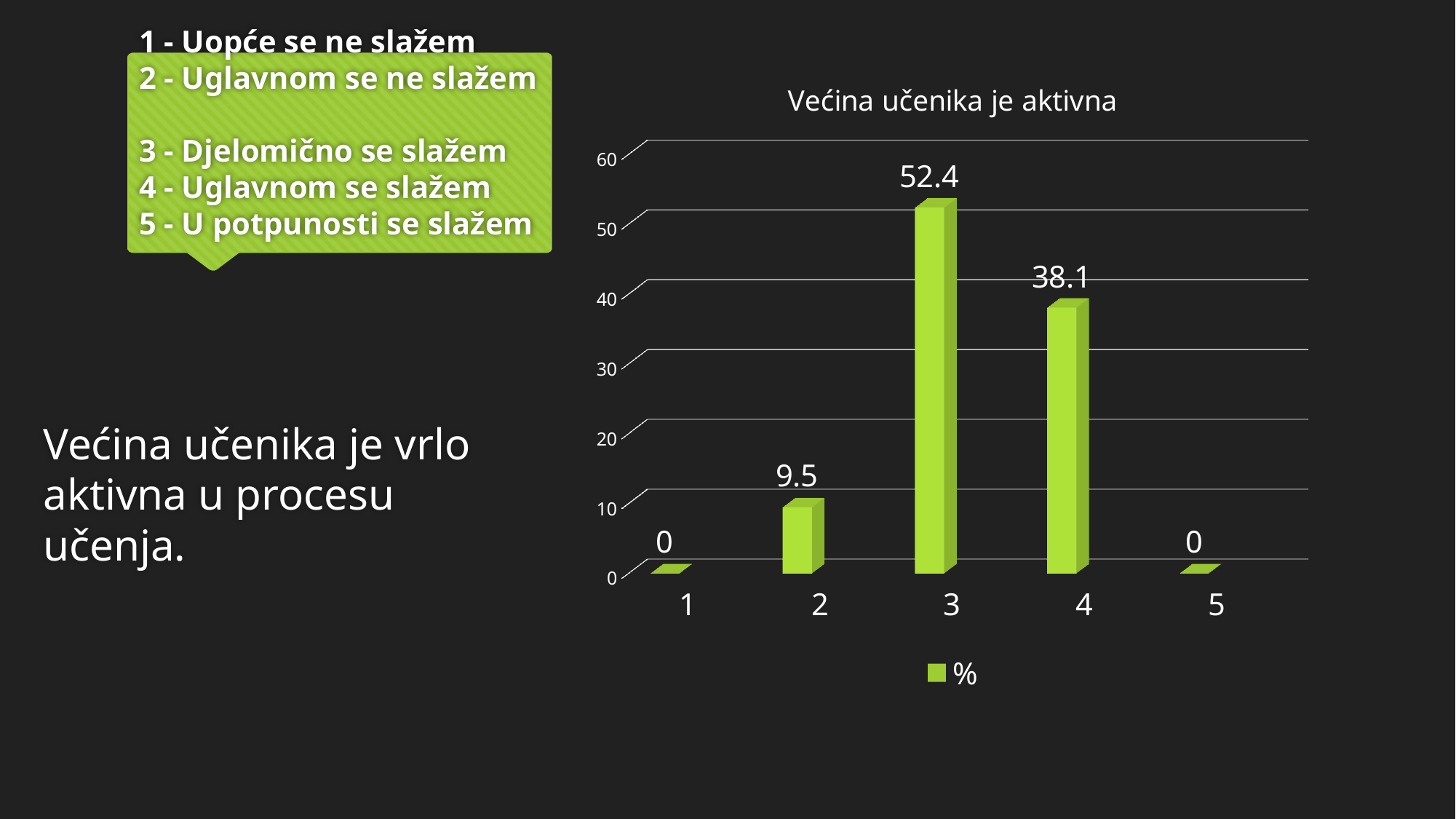
What kind of chart is shown? bar chart How many categories are shown on the x axis? 5 What is the difference between the values for categories 3 and 4? 14.3 What is the value for category 3? 52.4 What is the title of the chart? Većina učenika je aktivna How many series does the legend list? 1 What is the value for category 1? 0 Which category has the highest value? 3 Which is larger, the value for category 2 or the value for category 4? 4 What is the value for category 4? 38.1 Is the value for category 3 greater or less than 50? greater What is the value for category 2? 9.5